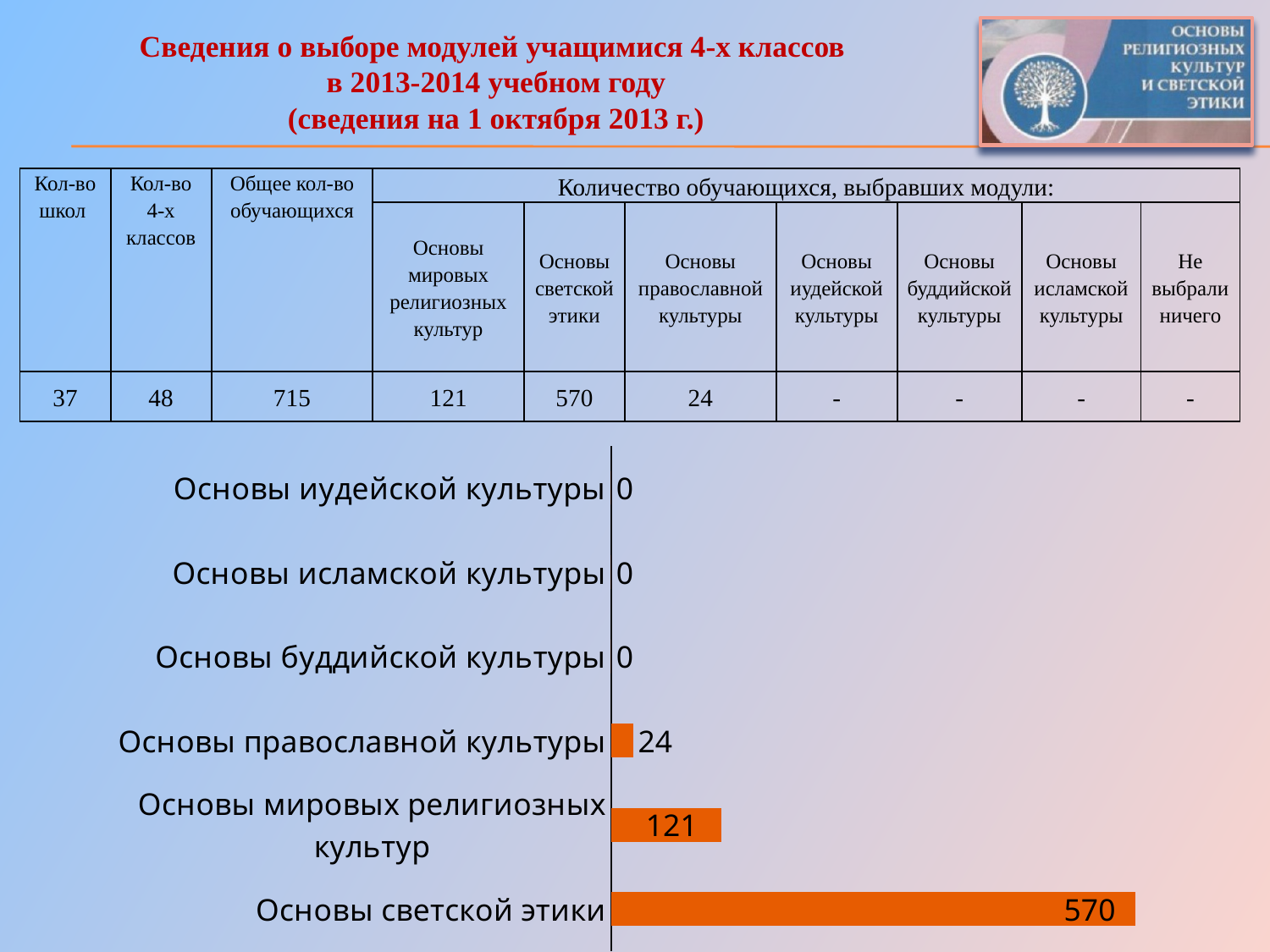
What is the difference between the values for Основы мировых религиозных культур and Основы православной культуры? 97 Which is larger in the bar chart: Основы православной культуры or Основы мировых религиозных культур? Основы мировых религиозных культур What value is shown for Основы светской этики in the bar chart? 570 What value is shown for Основы православной культуры in the bar chart? 24 What value is shown for Основы мировых религиозных культур in the bar chart? 121 What colour are the bars in the chart? orange Which category has the highest value in the bar chart? Основы светской этики What value is shown for Основы буддийской культуры in the bar chart? 0 How many categories are shown in the bar chart? 6 What kind of chart is shown on the slide? bar chart How many categories in the bar chart have a value of 0? 3 What is the difference between the values for Основы светской этики and Основы мировых религиозных культур? 449